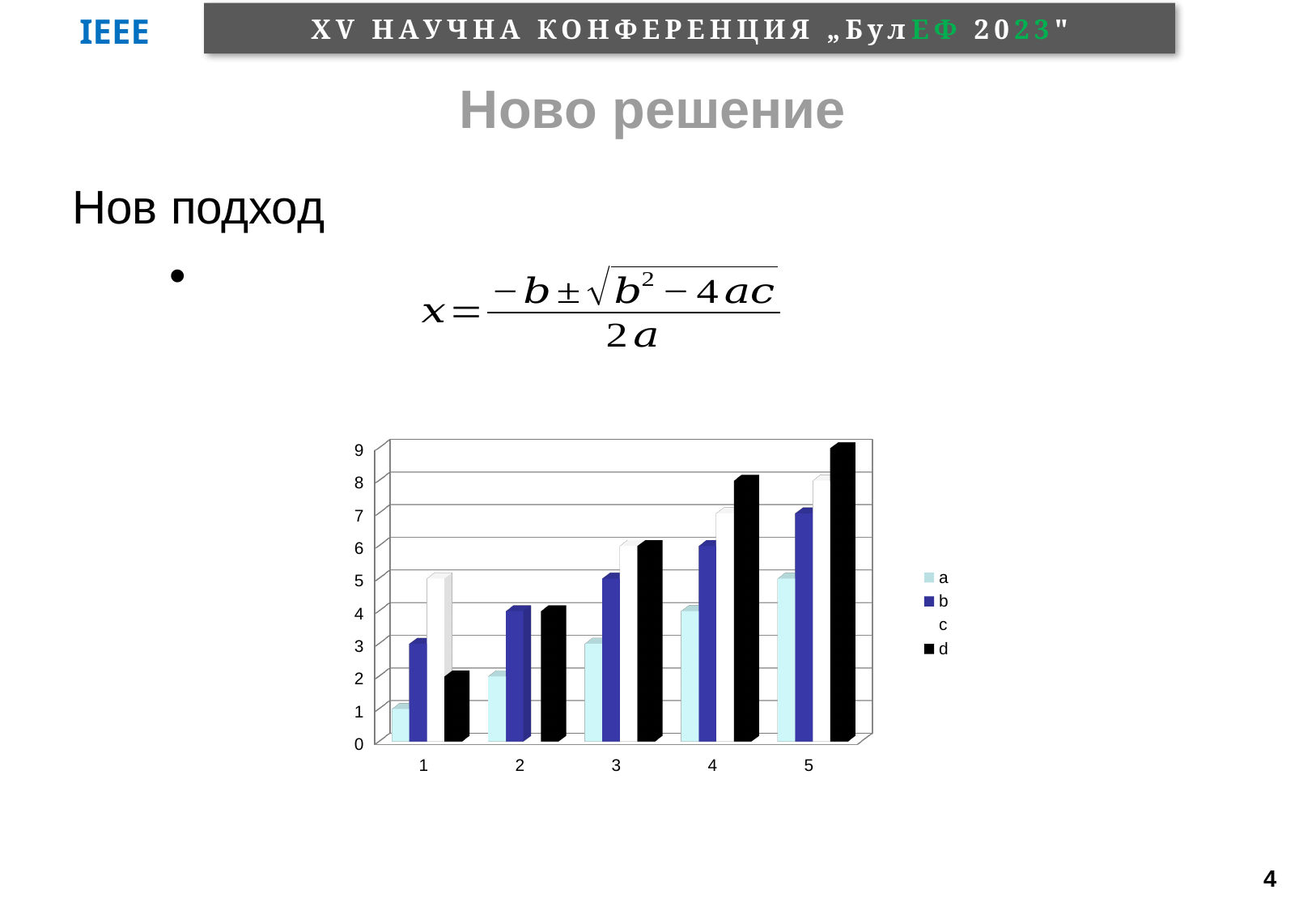
What is the value of series b for category 3? 5 Do the values of series a rise or fall from category 1 to category 5? rise What is the value of series a for category 1? 1 What is the value of series a for category 5? 5 Is the value of series d for category 4 greater or less than 6? greater What is the value of series d for category 5? 9 How many series does the chart legend list? 4 What kind of chart is shown on the slide? bar chart Which category has the lowest value for series a? 1 How many categories are shown on the x axis of the chart? 5 Which is larger for category 1: series b or series d? series b Which category has the highest value for series d? 5